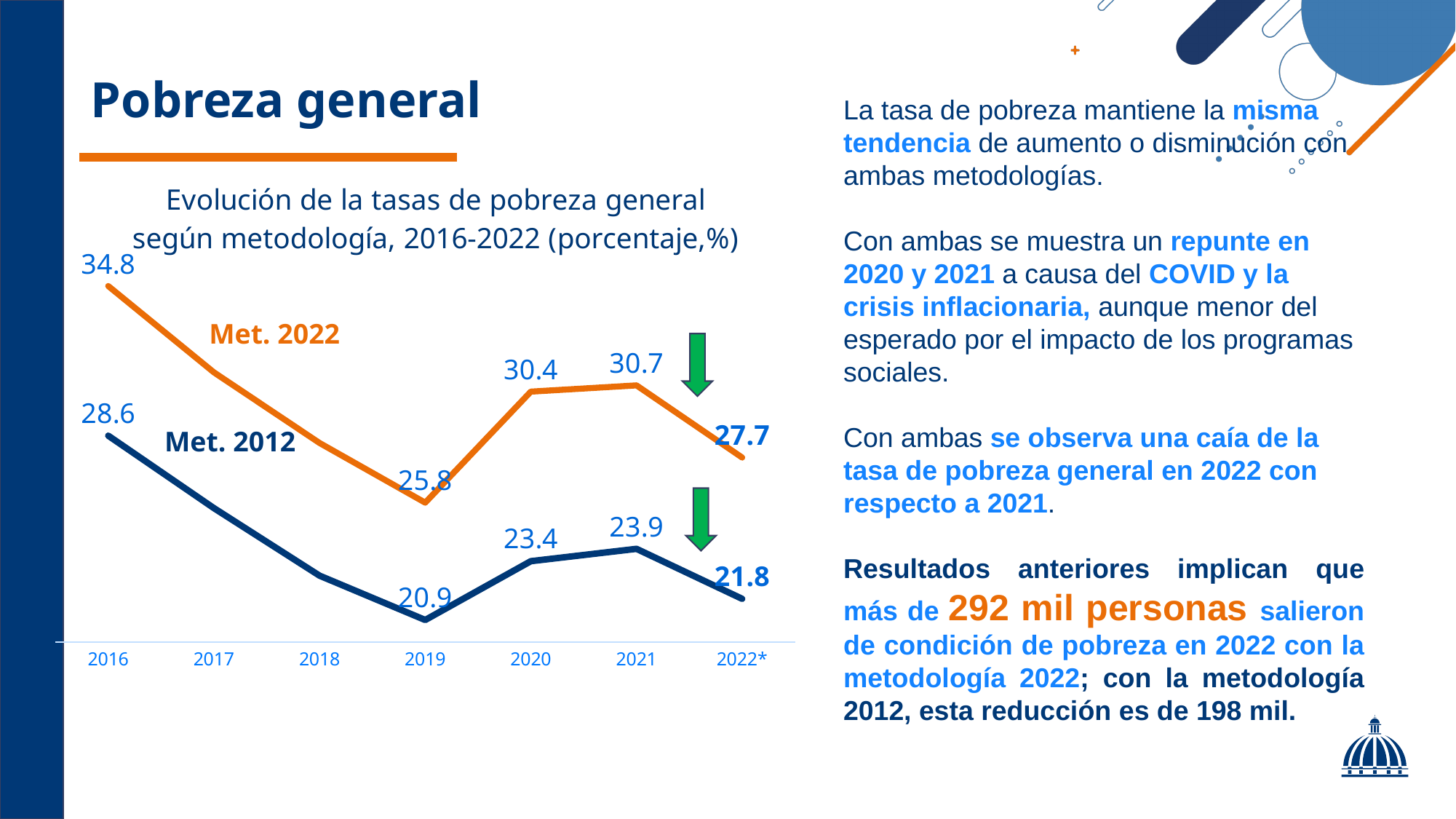
How many years are shown on the x axis? 7 Which series has the higher value in 2019, Met. 2022 or Met. 2012? Met. 2022 What is the value for Met. 2012 in 2019? 20.9 In which year is the Met. 2012 series at its lowest? 2019 In which year is the Met. 2022 series at its highest? 2016 How many series are plotted on the chart? 2 What is the difference between the Met. 2022 and Met. 2012 values in 2020? 7.0 What is the value for Met. 2022 in 2021? 30.7 What is the value for Met. 2022 in 2016? 34.8 What is the value for Met. 2012 in 2022*? 21.8 What is the difference between the Met. 2022 value in 2021 and in 2022*? 3.0 What type of chart is shown on the slide? line chart